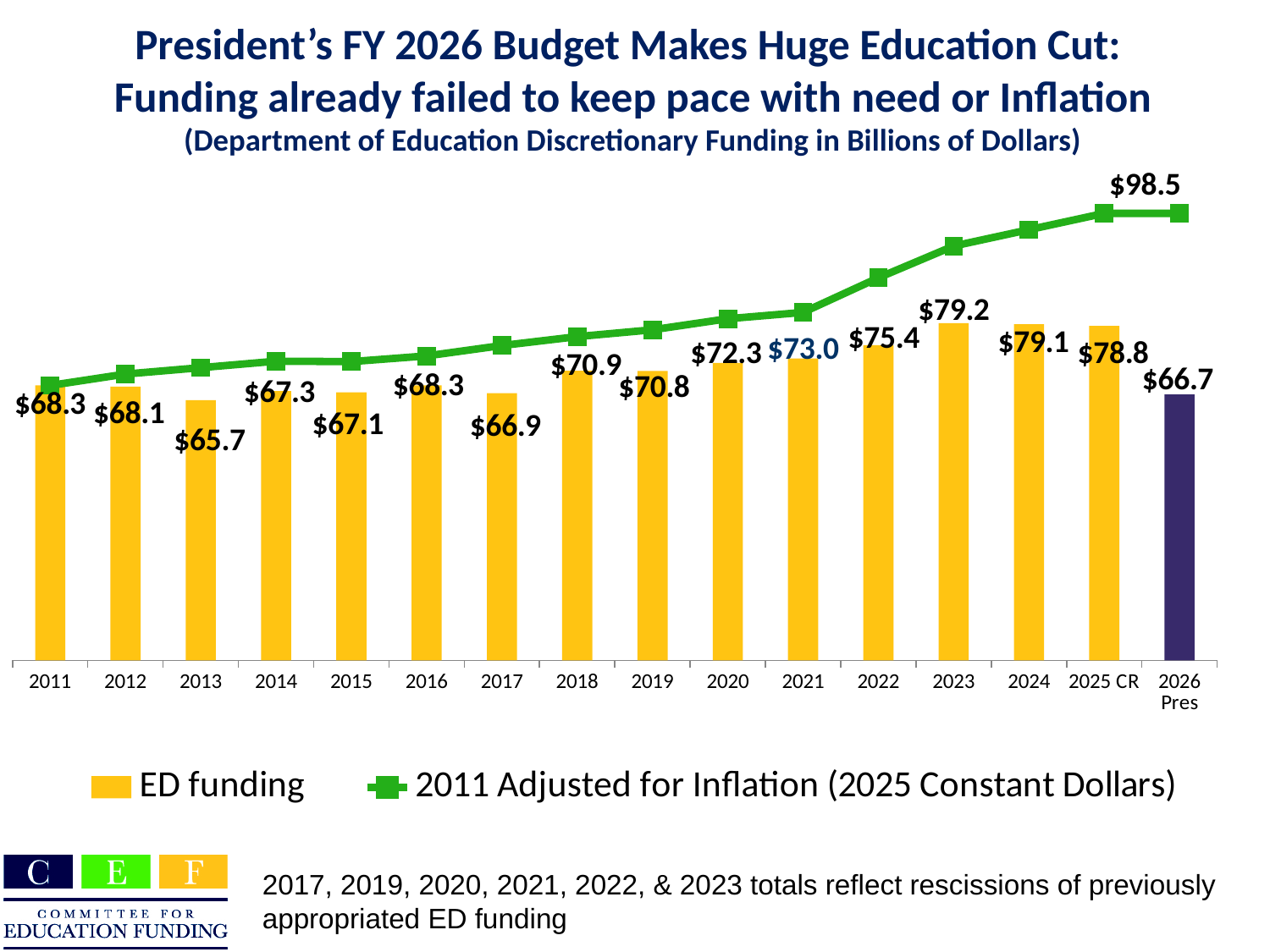
How many categories are shown on the x axis? 16 What is the ED funding value for the 2026 Pres category? $66.7 What unit does the chart subtitle say the funding is measured in? Billions of Dollars What is the ED funding value for 2018? $70.9 What is the value of the 2011 Adjusted for Inflation line at its final labeled point? $98.5 Does the 2011 Adjusted for Inflation line rise or fall from 2011 to 2025 CR? rise How many series does the legend list? 2 Which year has the lowest ED funding bar? 2013 What is the ED funding value for 2023? $79.2 Which year has the highest ED funding bar? 2023 What is the difference between ED funding for 2025 CR and 2026 Pres? $12.1 Which is larger, ED funding in 2020 or in 2021? 2021